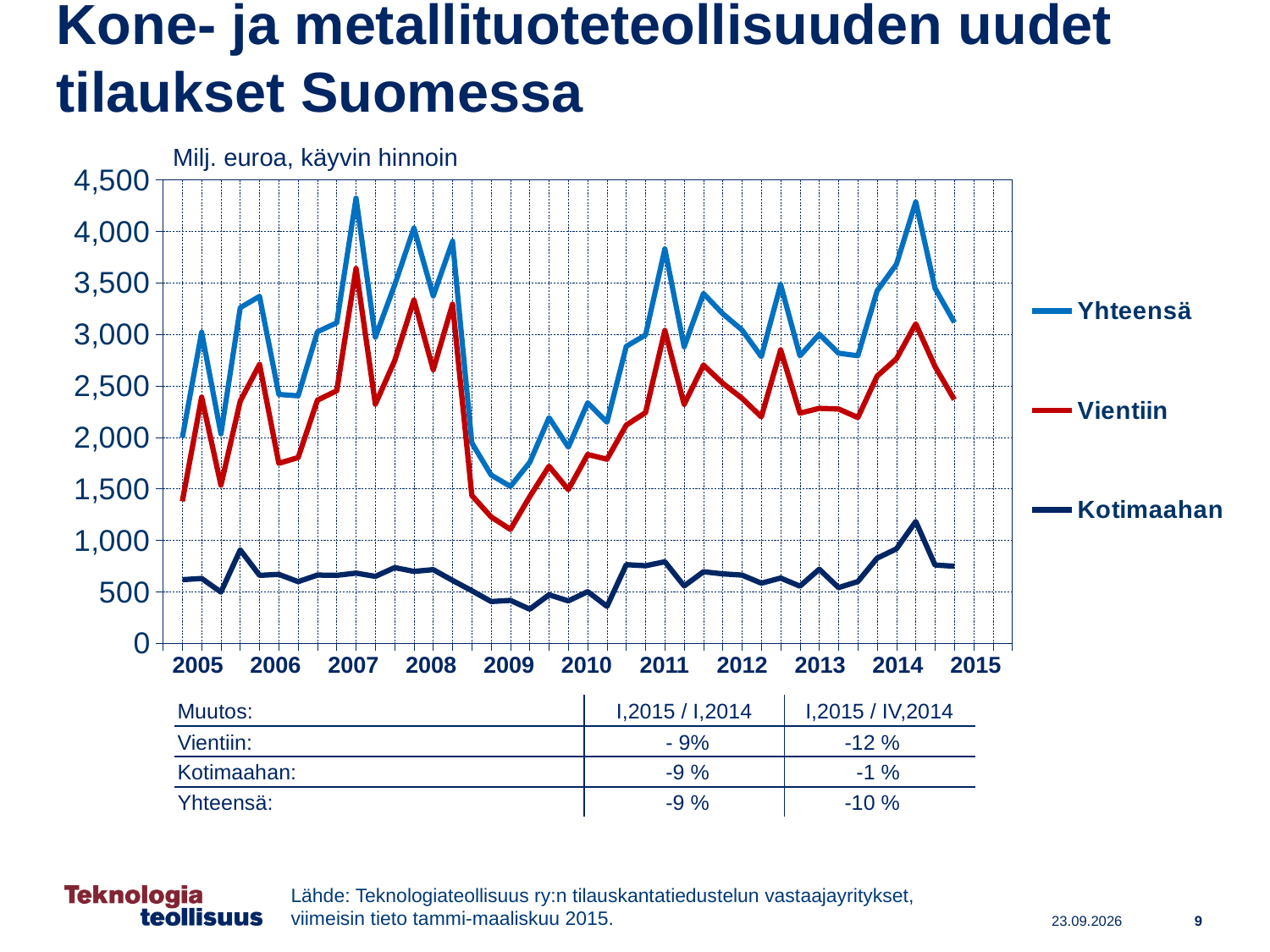
Which series has the lowest values throughout the chart? Kotimaahan In which year does the Yhteensä series reach its lowest point? 2009 Is the lowest value of Vientiin in 2009 greater or less than 1,500? less What kind of chart is shown on the slide? line chart In which year does the Kotimaahan series reach its highest point? 2014 Is the peak value of Yhteensä in 2007 greater or less than 4,000? greater What unit is stated above the chart? Milj. euroa, käyvin hinnoin Does the Yhteensä series rise or fall from its 2014 peak to the last point in 2015? fall How many series does the legend list? 3 Which series has the highest values throughout the chart? Yhteensä How many years are labelled on the x axis? 11 What are the three series named in the legend? Yhteensä, Vientiin, Kotimaahan